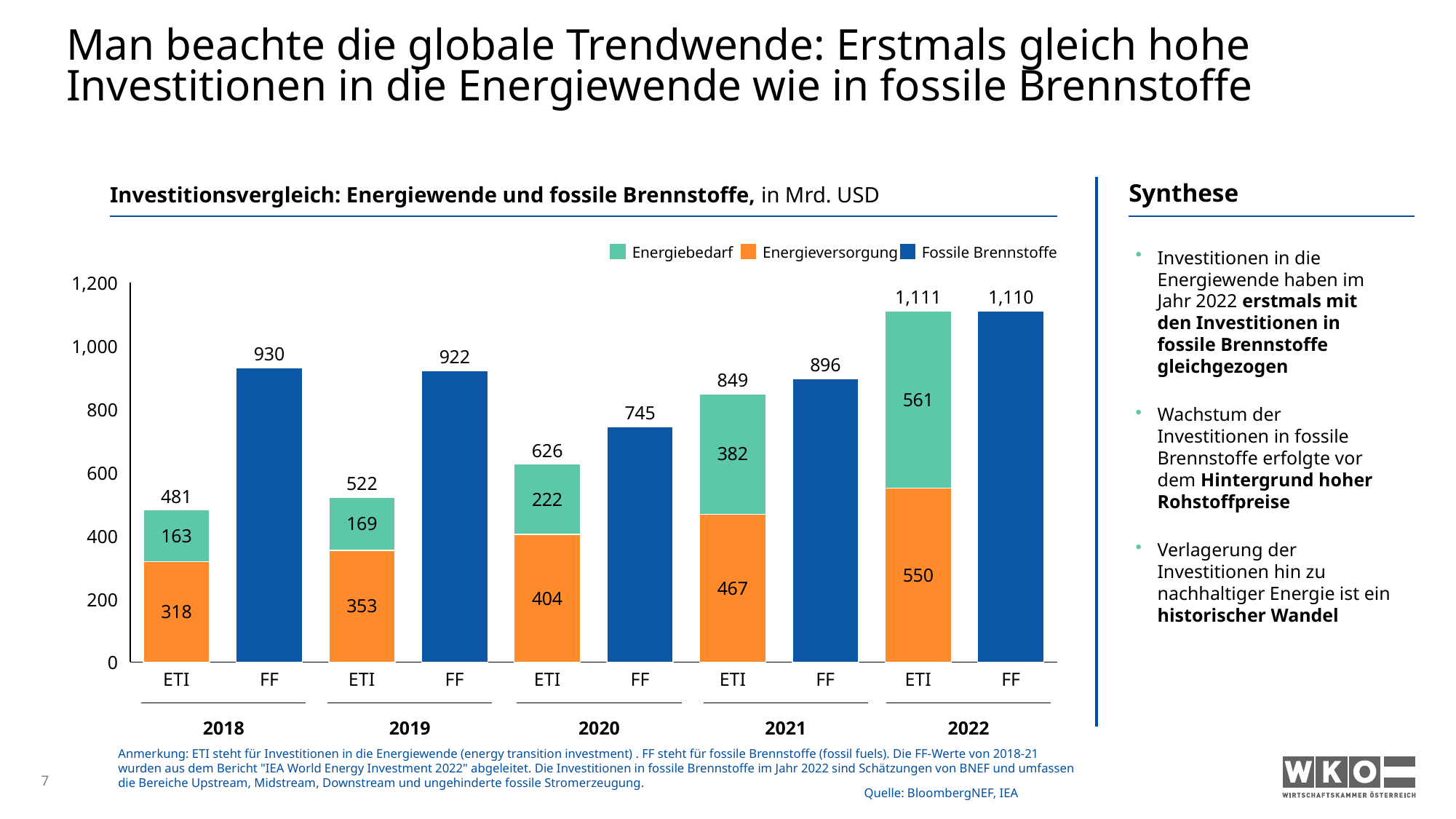
In which year is the FF bar highest? 2022 Do the ETI totals rise or fall from 2018 to 2022? Rise By how much did the Energiebedarf value increase from 2021 to 2022? 179 What is the difference between the FF bar and the ETI bar in 2018? 449 What is the total of the stacked ETI bar in 2021? 849 What is the Energieversorgung value for ETI in 2020? 404 In 2020, which bar is larger, ETI or FF? FF In which year is the ETI bar lowest? 2018 How many series does the legend list? 3 What is the value of the FF bar in 2019? 922 What kind of chart is shown on the slide? Stacked bar chart How many years are shown on the x axis? 5